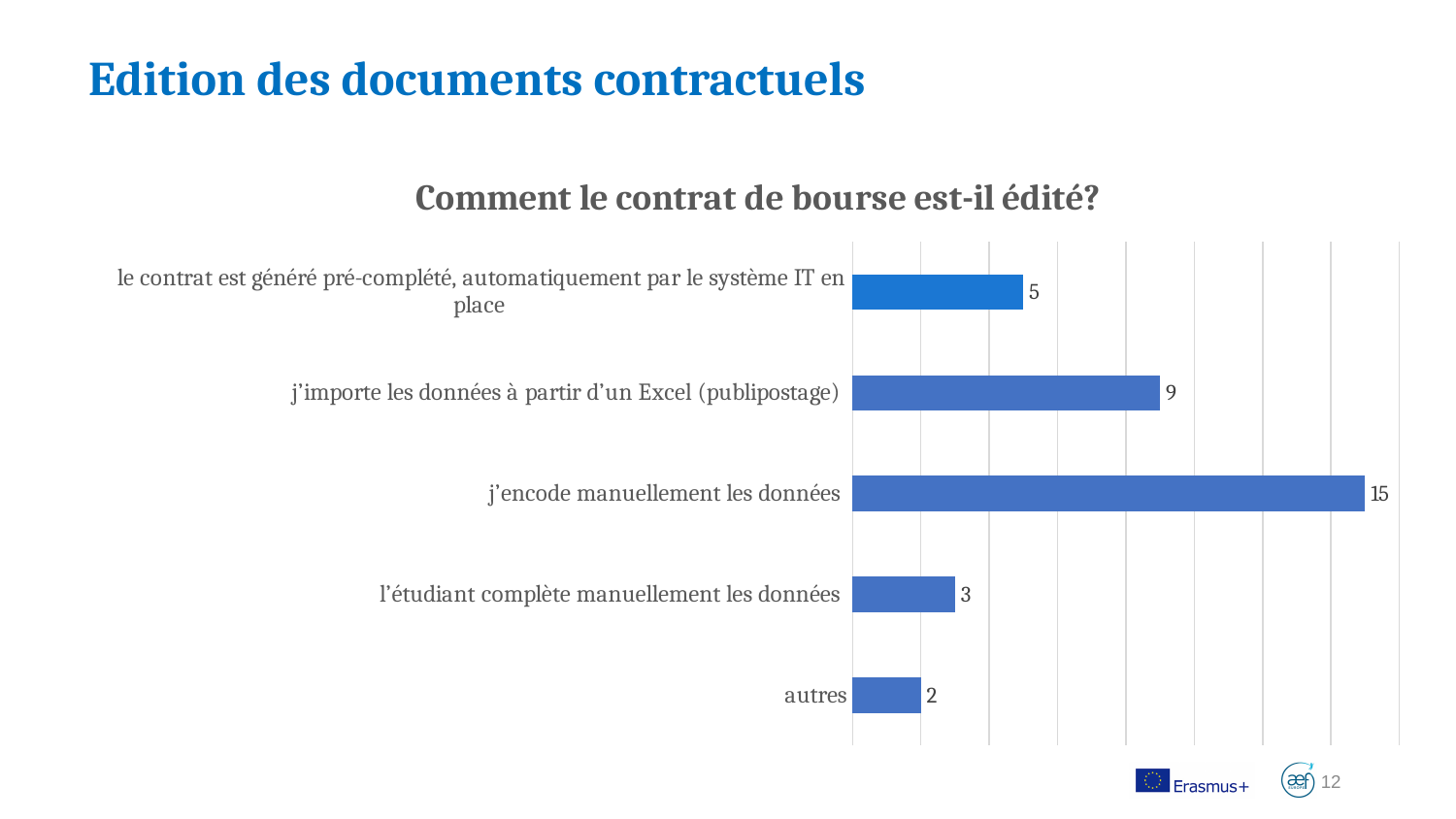
How many categories are shown in the chart? 5 What is the difference between the values for "le contrat est généré pré-complété, automatiquement par le système IT en place" and "autres"? 3 What kind of chart is shown on the slide? bar chart What is the value for "j'encode manuellement les données"? 15 What is the value for "j'importe les données à partir d'un Excel (publipostage)"? 9 Which category has the highest value? j'encode manuellement les données What is the value for "l'étudiant complète manuellement les données"? 3 What is the difference between the values for "j'encode manuellement les données" and "j'importe les données à partir d'un Excel (publipostage)"? 6 What is the value for "autres"? 2 Which is larger: the value for "le contrat est généré pré-complété, automatiquement par le système IT en place" or the value for "l'étudiant complète manuellement les données"? le contrat est généré pré-complété, automatiquement par le système IT en place Which category has the lowest value? autres What is the title of the chart? Comment le contrat de bourse est-il édité?